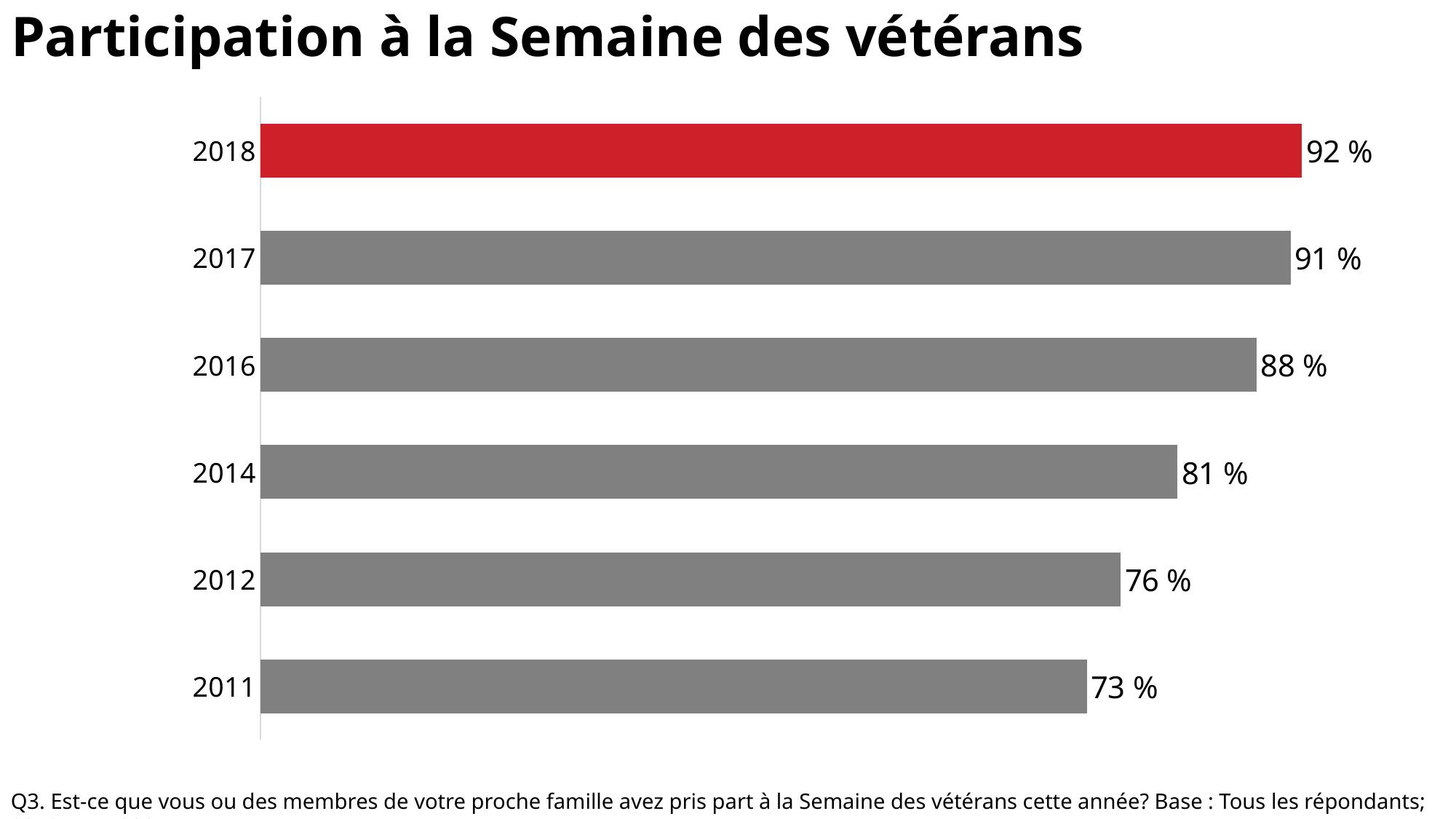
How many years are shown in the chart? 6 Which year has the lowest value? 2011 What is the value for 2018? 92 % Which is larger, the value for 2012 or the value for 2016? 2016 What is the difference between the values for 2018 and 2011? 19 % What is the value for 2011? 73 % What is the title of the chart? Participation à la Semaine des vétérans What is the difference between the values for 2016 and 2014? 7 % What is the value for 2014? 81 % What kind of chart is this? bar chart Do the values rise or fall from 2011 to 2018? rise Which year has the highest value? 2018